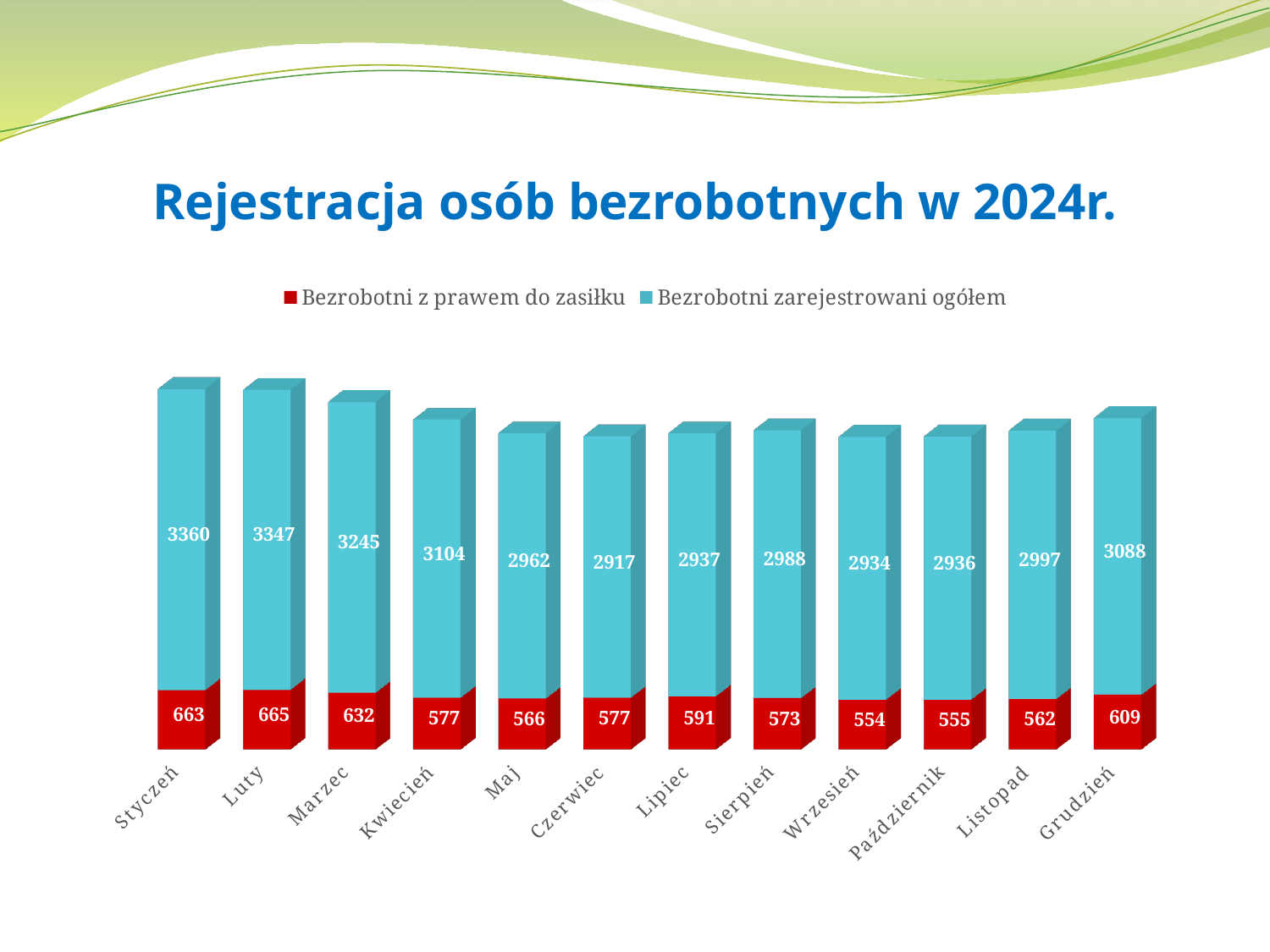
How many months (categories) are shown on the x axis? 12 Which month has the highest value for 'Bezrobotni zarejestrowani ogółem'? Styczeń Which month has the lowest value for 'Bezrobotni z prawem do zasiłku'? Wrzesień What is the value of 'Bezrobotni zarejestrowani ogółem' for Styczeń? 3360 What is the difference between the 'Bezrobotni zarejestrowani ogółem' values for Styczeń and Grudzień? 272 What type of chart is shown on the slide? bar chart What is the value of 'Bezrobotni z prawem do zasiłku' for Grudzień? 609 What is the total of the stacked bar for Styczeń? 4023 Which is larger: the 'Bezrobotni z prawem do zasiłku' value for Luty or for Marzec? Luty How many series does the legend list? 2 Which colour represents 'Bezrobotni z prawem do zasiłku' in the legend? red What is the value of 'Bezrobotni zarejestrowani ogółem' for Sierpień? 2988